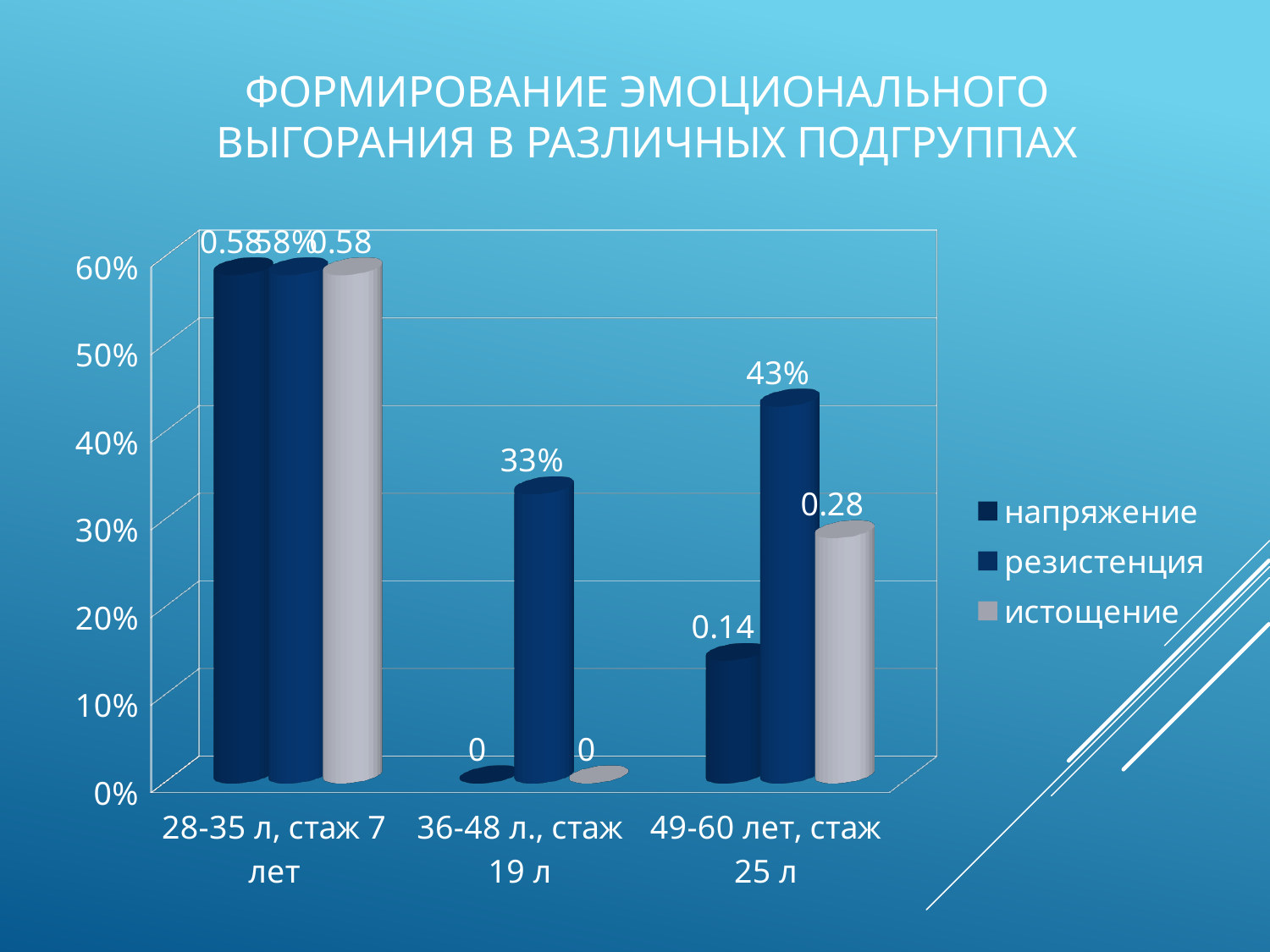
Which group has the highest value for резистенция? 28-35 л, стаж 7 лет What is the value of резистенция for the group 49-60 лет, стаж 25 л? 43% Which group has the larger резистенция value: 36-48 л., стаж 19 л or 49-60 лет, стаж 25 л? 49-60 лет, стаж 25 л What is the value of резистенция for the group 36-48 л., стаж 19 л? 33% What is the value of истощение for the group 49-60 лет, стаж 25 л? 0.28 What are the three series listed in the legend? напряжение, резистенция, истощение How many categories are shown on the x axis? 3 How many series does the legend list? 3 Is the резистенция value for 49-60 лет, стаж 25 л greater or less than 40%? greater What is the value of напряжение for the group 36-48 л., стаж 19 л? 0 What kind of chart is shown on the slide? bar chart What is the value of напряжение for the group 49-60 лет, стаж 25 л? 0.14